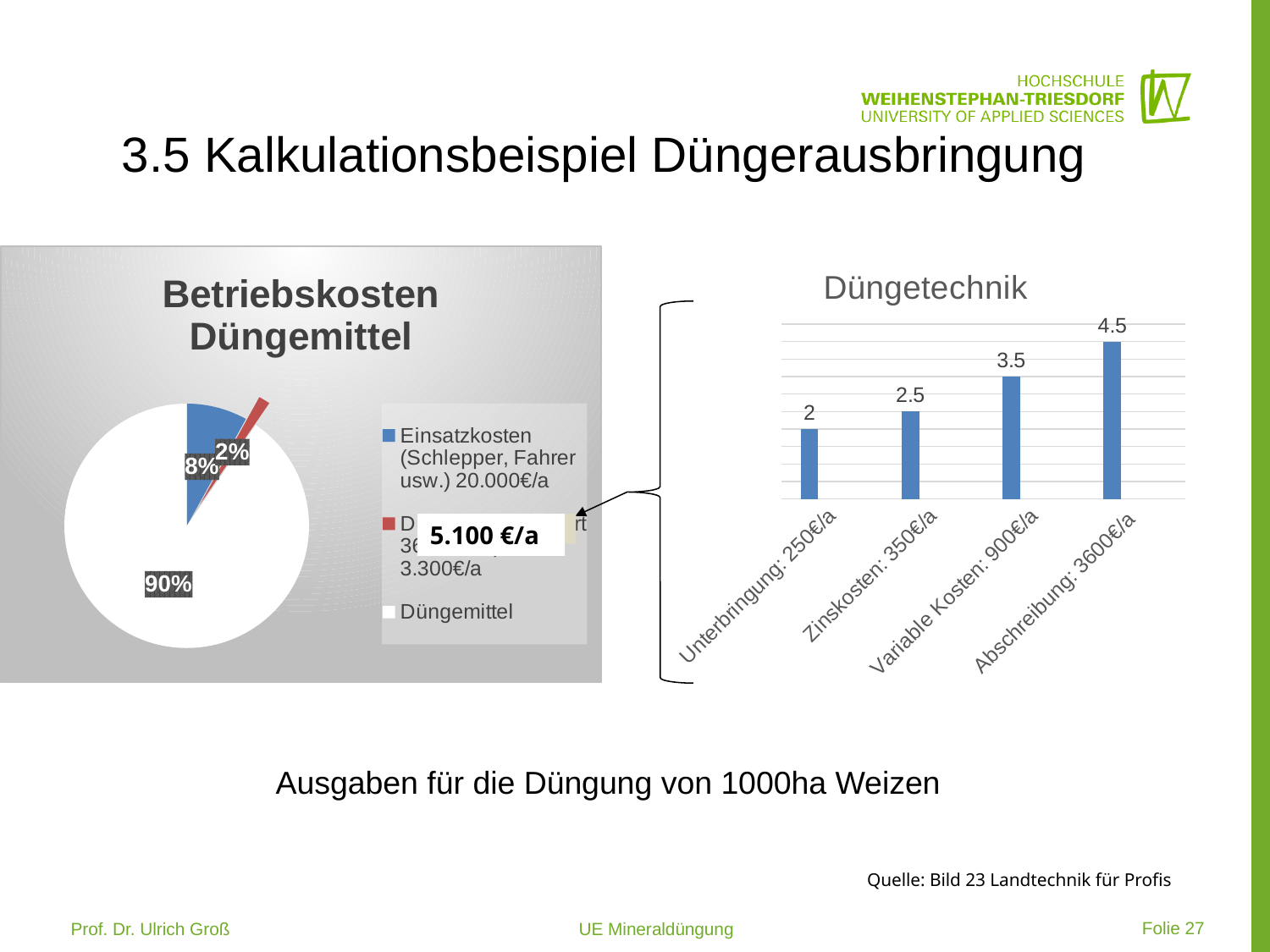
What kind of chart is the Betriebskosten Düngemittel chart? pie chart In the Düngetechnik chart, what is the value for Zinskosten: 350€/a? 2.5 In the Düngetechnik chart, do the values rise or fall from left to right? rise In the Betriebskosten Düngemittel chart, what share does the Einsatzkosten (Schlepper, Fahrer usw.) slice have? 8% In the Betriebskosten Düngemittel chart, what share does the Düngemittel slice have? 90% What kind of chart is the Düngetechnik chart? bar chart In the Düngetechnik chart, which category has the highest value? Abschreibung: 3600€/a In the Düngetechnik chart, what is the difference between the values for Abschreibung: 3600€/a and Variable Kosten: 900€/a? 1 In the Düngetechnik chart, what is the value for Abschreibung: 3600€/a? 4.5 In the Düngetechnik chart, what is the value for Unterbringung: 250€/a? 2 In the Düngetechnik chart, which category has the lowest value? Unterbringung: 250€/a In the Düngetechnik chart, how many bars are shown? 4